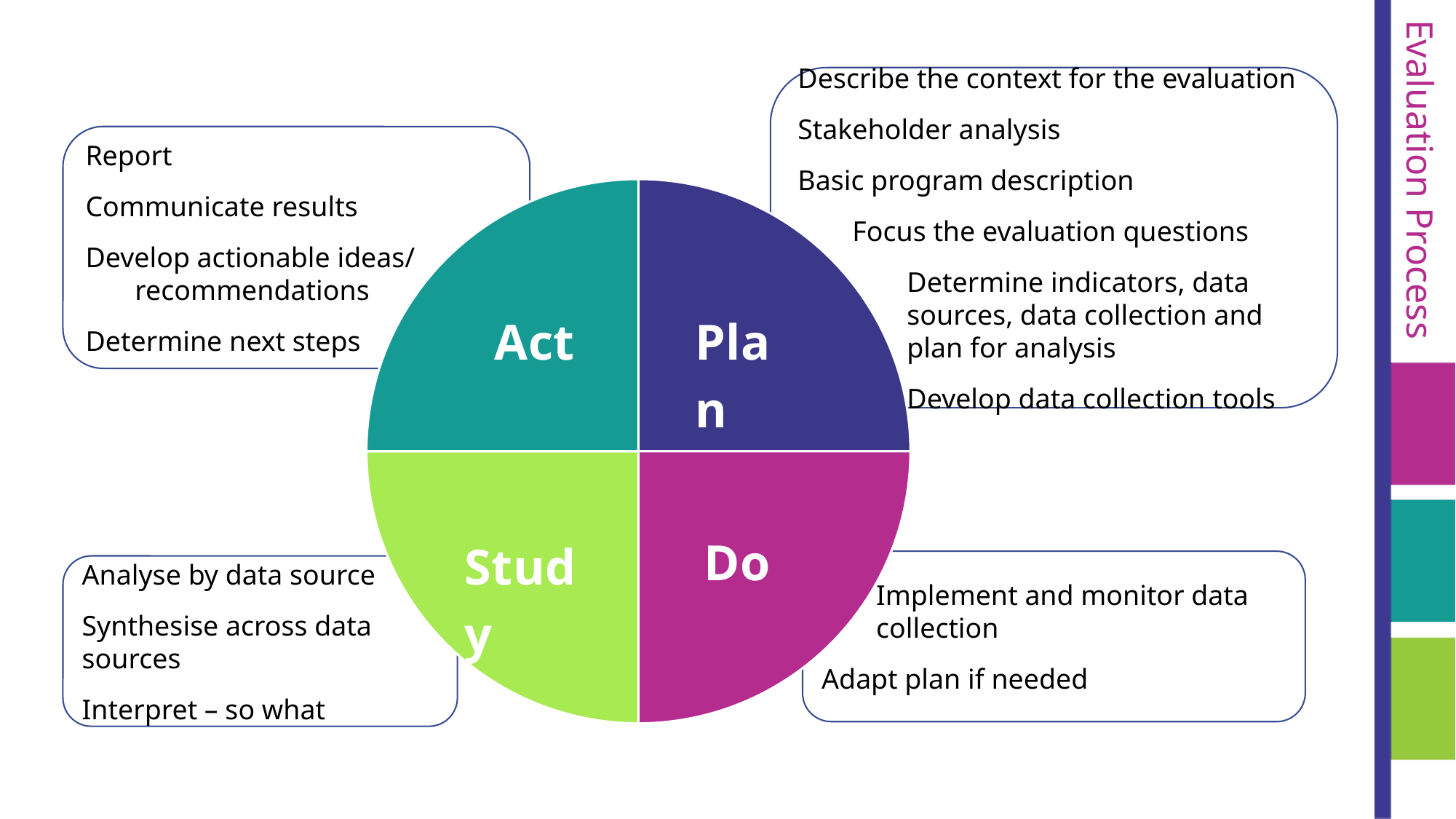
What colour is the Plan slice of the pie chart? dark purple Which slice of the pie chart is coloured light green? Study What kind of chart is shown in the centre of the slide? pie chart How many slices does the pie chart have? 4 What are the labels of the four slices of the pie chart? Act, Plan, Do, Study